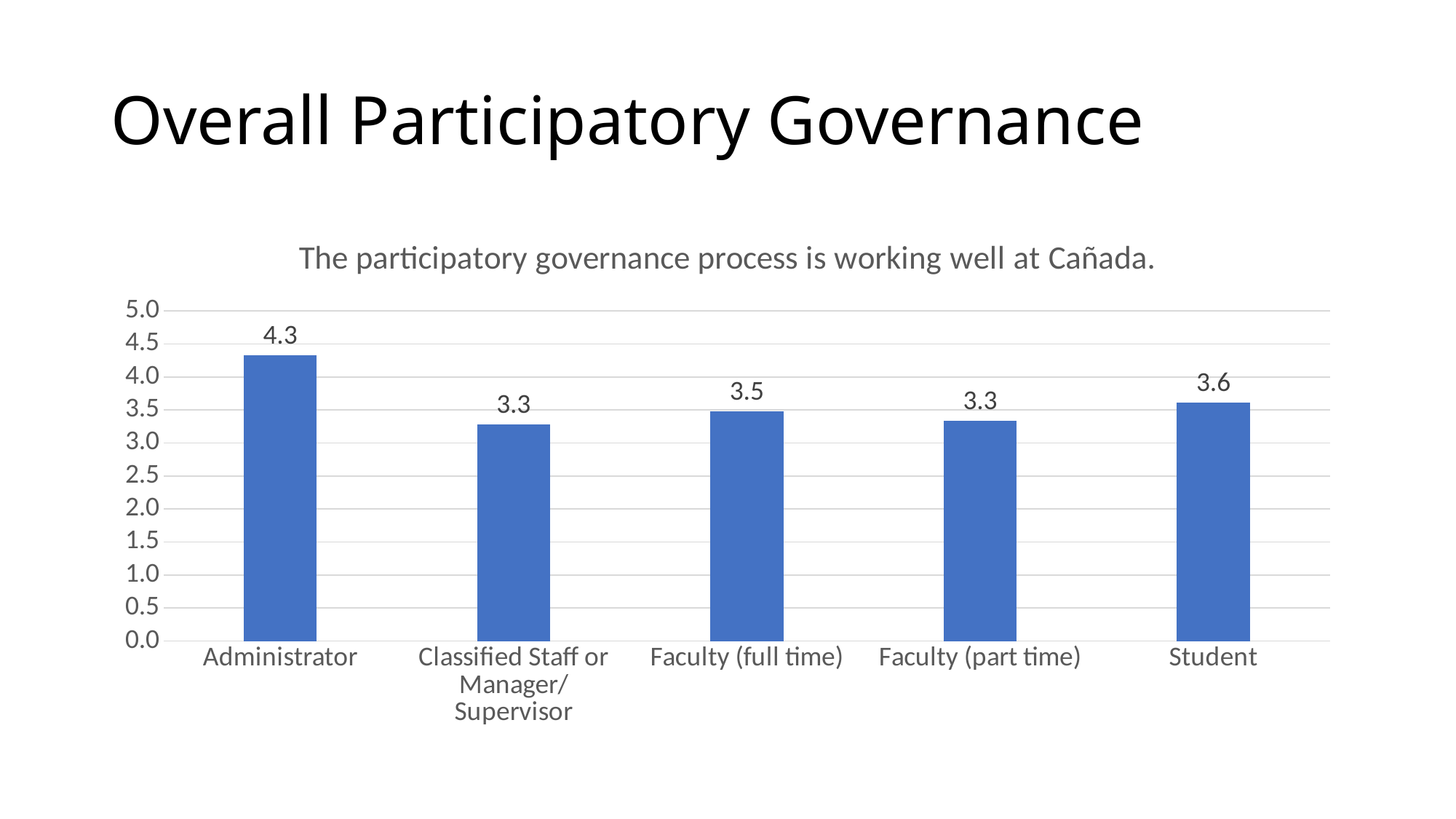
What is the value for Classified Staff or Manager/Supervisor? 3.3 Which category has the highest value? Administrator What is the difference between the values for Faculty (full time) and Faculty (part time)? 0.2 Is the value for Administrator greater or less than 4.0? greater What kind of chart is shown on the slide? bar chart What is the value for Faculty (full time)? 3.5 Which is larger, the value for Student or the value for Faculty (full time)? Student What is the title of the chart? The participatory governance process is working well at Cañada. What is the difference between the values for Administrator and Student? 0.7 What is the value for Administrator? 4.3 What is the value for Student? 3.6 How many categories are shown on the x axis? 5